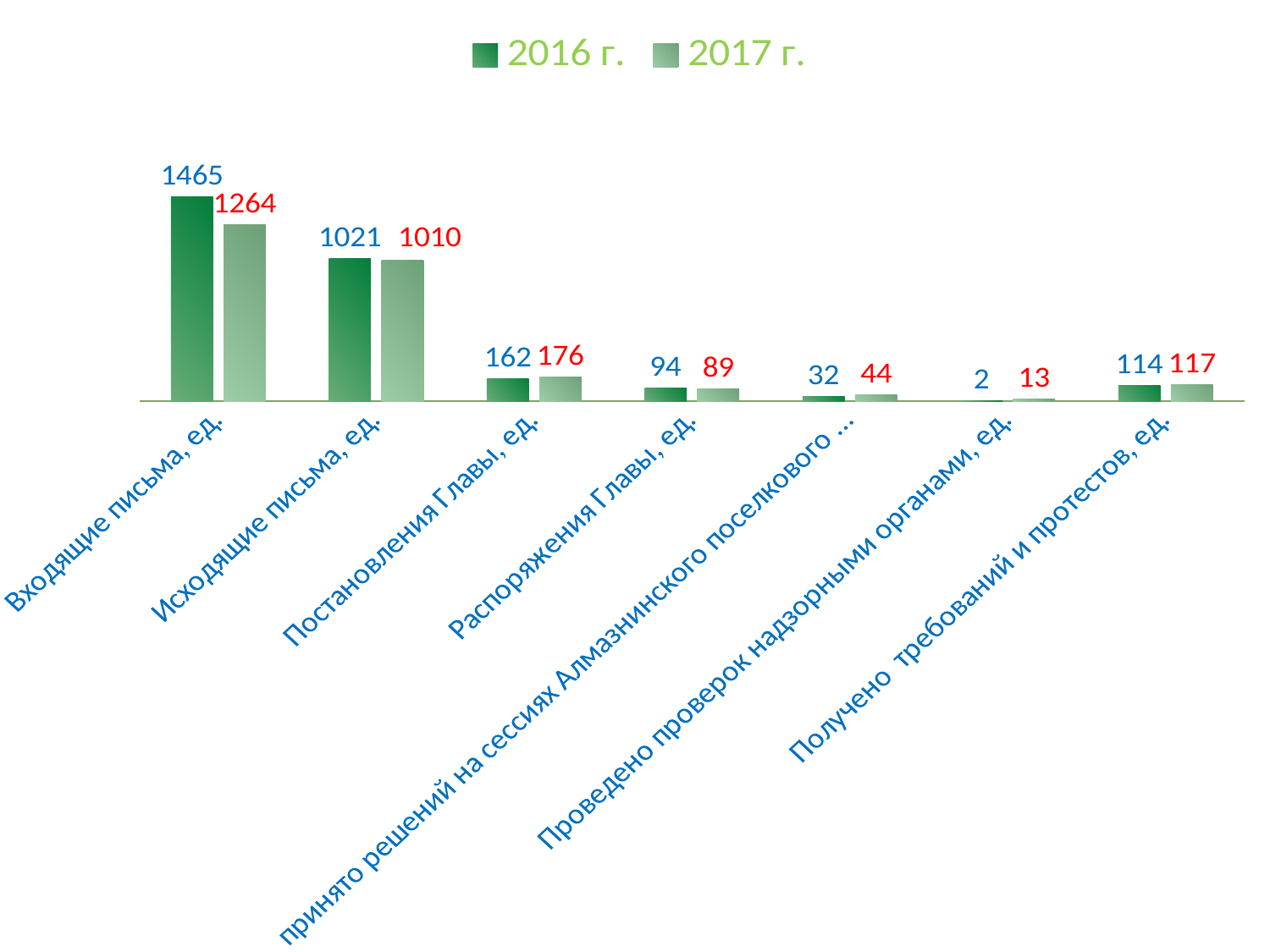
What is the value for 2017 г. for Проведено проверок надзорными органами, ед.? 13 What are the two series named in the legend? 2016 г. and 2017 г. What is the difference between the 2016 г. and 2017 г. values for Входящие письма, ед.? 201 Which category has the highest value for 2016 г.? Входящие письма, ед. What is the value for 2016 г. for Входящие письма, ед.? 1465 How many series does the legend list? 2 Which category has the lowest value for 2017 г.? Проведено проверок надзорными органами, ед. What is the value for 2016 г. for Получено требований и протестов, ед.? 114 How many categories are shown on the x axis? 7 For Постановления Главы, ед., which is larger: the 2016 г. value or the 2017 г. value? 2017 г. What kind of chart is shown on the slide? Bar chart What is the value for 2017 г. for Исходящие письма, ед.? 1010